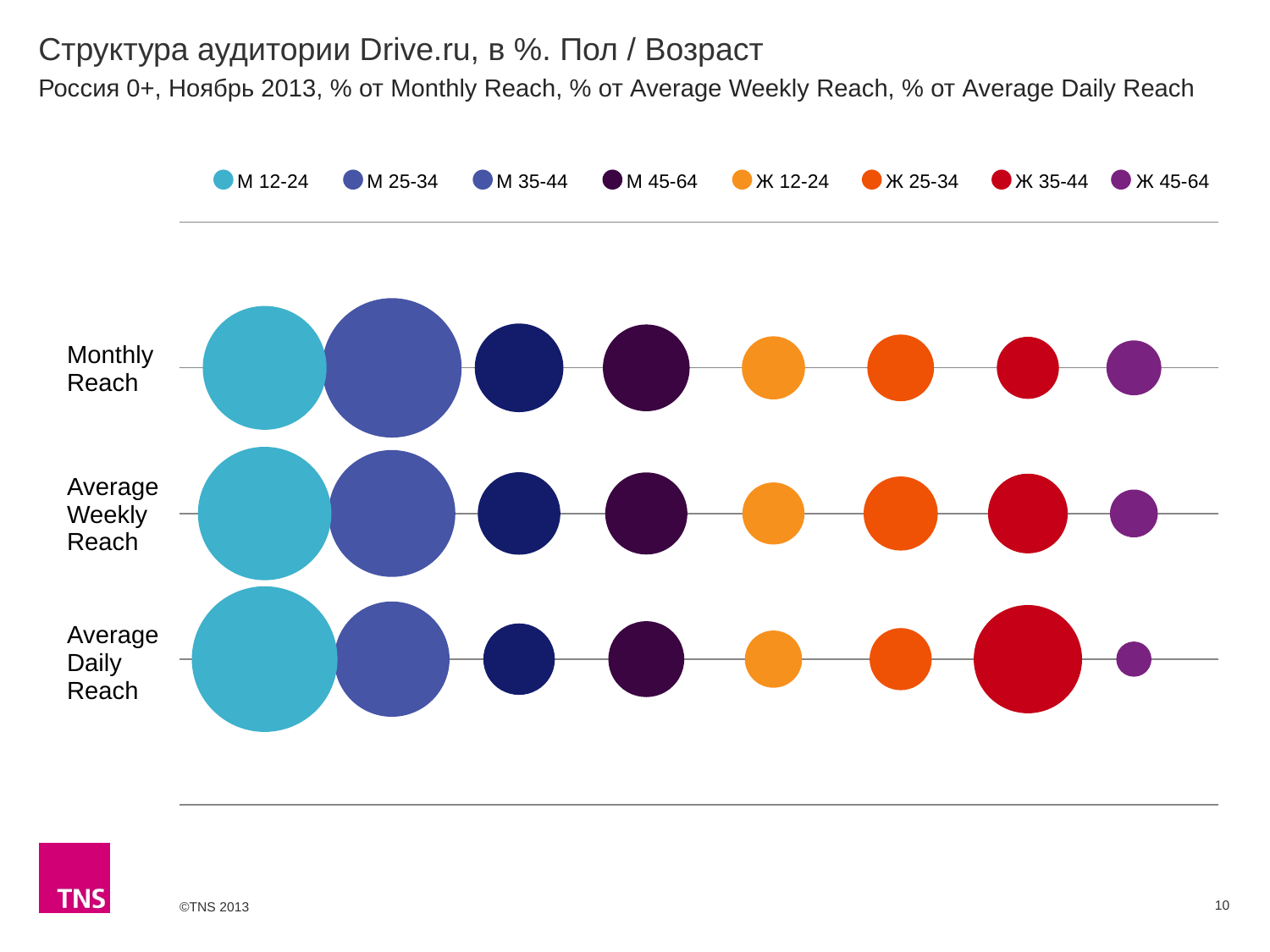
In the Average Weekly Reach row, which bubble is larger: М 25-34 or М 35-44? М 25-34 Which series has the largest bubble in the Average Daily Reach row? М 12-24 In the Monthly Reach row, which bubble is larger: Ж 25-34 or Ж 35-44? Ж 25-34 Does the Ж 45-64 bubble grow or shrink going from Monthly Reach to Average Daily Reach? Shrinks Which series has the smallest bubble in the Monthly Reach row? Ж 45-64 Which series has the smallest bubble in the Average Daily Reach row? Ж 45-64 What kind of chart is shown on the slide? Bubble chart What is the title of the chart on the slide? Структура аудитории Drive.ru, в %. Пол / Возраст Does the Ж 35-44 bubble grow or shrink going from Monthly Reach to Average Weekly Reach to Average Daily Reach? Grows In the Average Daily Reach row, which bubble is larger: Ж 25-34 or Ж 35-44? Ж 35-44 How many reach categories (rows) are plotted on the chart? 3 How many series does the legend list? 8